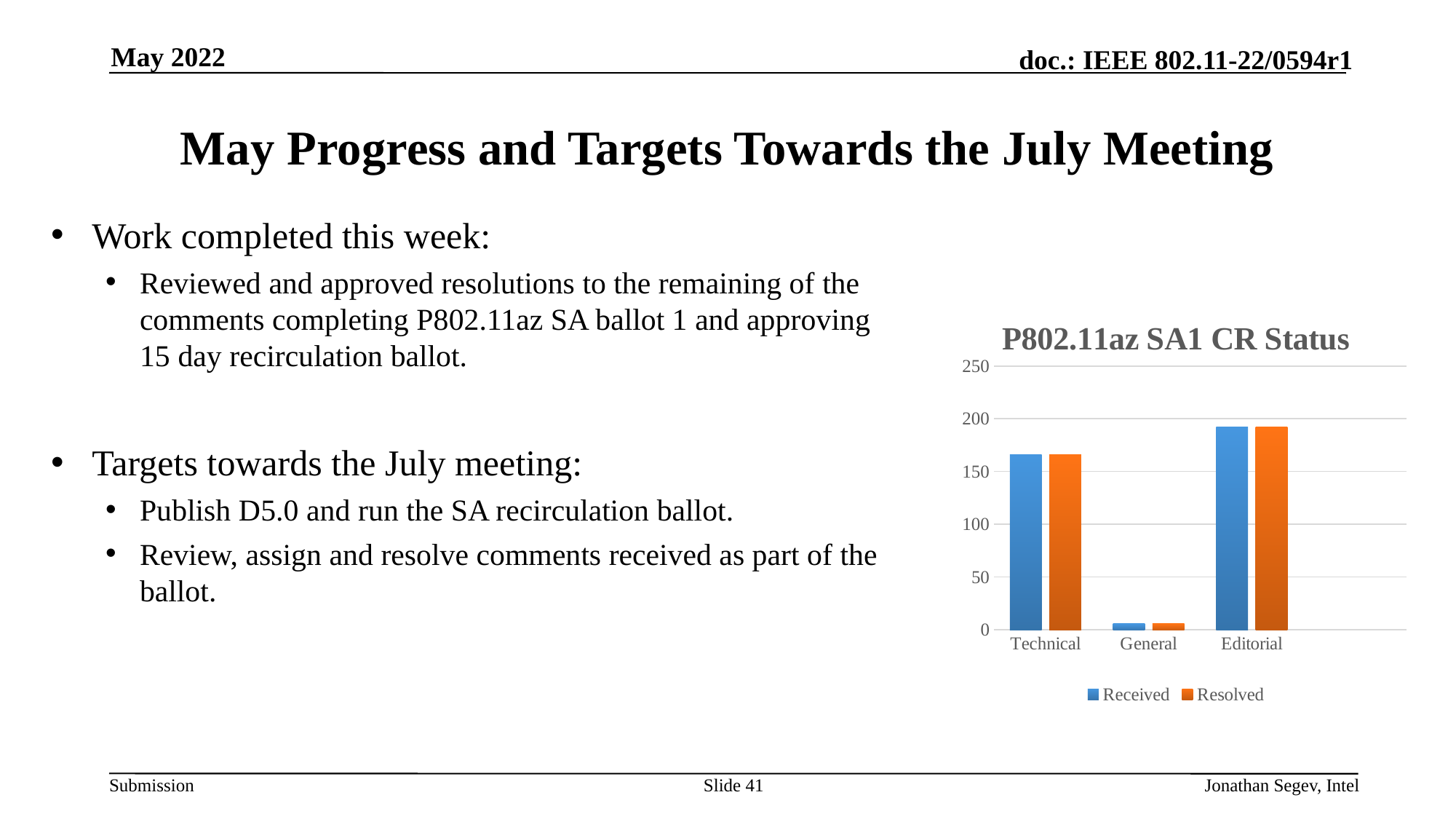
Which is larger, the Received value for Editorial or the Received value for Technical? Editorial Which category has the highest Received value? Editorial How many categories are shown on the x axis of the chart? 3 How many series does the chart's legend list? 2 Is the Resolved value for General greater or less than 50? less Is the Resolved value for Editorial greater or less than 150? greater What kind of chart is shown on the slide? bar chart Is the Received value for Editorial greater or less than 200? less Which series is shown in orange in the chart? Resolved What is the title of the chart? P802.11az SA1 CR Status Which category has the lowest Resolved value? General